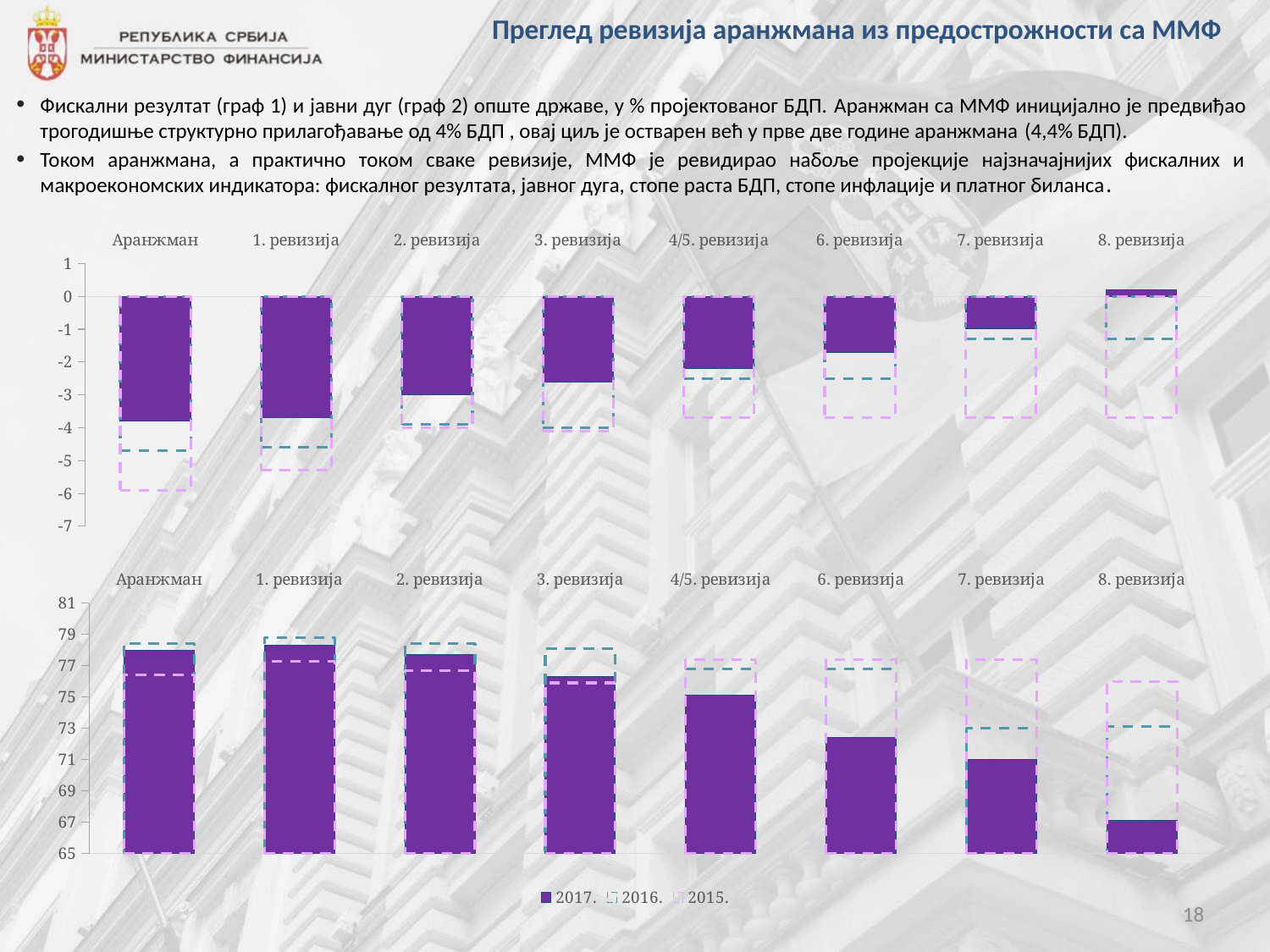
In the bottom chart, is the 2017. value for 6. ревизија greater or less than 73? less Which series are listed in the legend at the bottom of the slide? 2017., 2016., 2015. How many series does the legend at the bottom of the slide list? 3 In the top chart, is the 2017. value for Аранжман greater or less than -3? less In the bottom chart, which is larger, the 2017. value for Аранжман or for 8. ревизија? Аранжман In the top chart, is the 2017. value for 6. ревизија greater or less than -1? less What kind of chart is the top chart on the slide? bar chart In the top chart, do the solid 2017. bars rise or fall from Аранжман to 8. ревизија? rise In the bottom chart, do the solid 2017. bars rise or fall from Аранжман to 8. ревизија? fall In the top chart, which category has the highest 2017. value? 8. ревизија In the bottom chart, which category has the lowest 2017. value? 8. ревизија How many categories are shown on the x axis of the bottom chart? 8